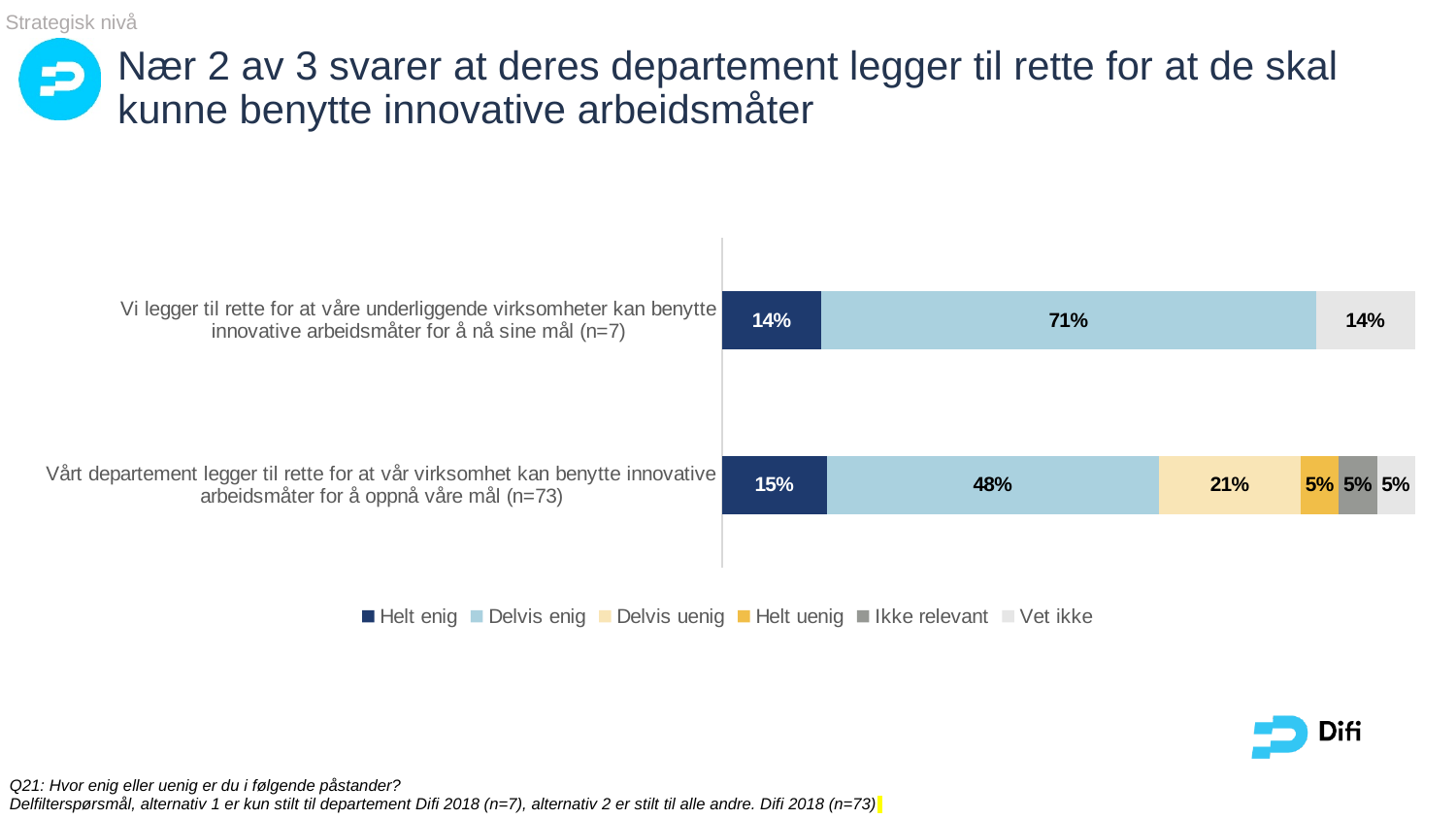
What is the 'Helt enig' value for the statement 'Vårt departement legger til rette for at vår virksomhet kan benytte innovative arbeidsmåter for å oppnå våre mål (n=73)'? 15% What is the difference between the 'Delvis enig' values of the two statements (71% vs 48%)? 23% What is the 'Delvis uenig' value for the statement 'Vårt departement legger til rette for at vår virksomhet kan benytte innovative arbeidsmåter for å oppnå våre mål (n=73)'? 21% Which statement has the larger 'Delvis enig' share: the one with n=7 or the one with n=73? The one with n=7 How many statements (categories) are plotted in the chart? 2 What is the 'Helt uenig' value for the statement 'Vårt departement legger til rette for at vår virksomhet kan benytte innovative arbeidsmåter for å oppnå våre mål (n=73)'? 5% What is the 'Delvis enig' value for the statement 'Vi legger til rette for at våre underliggende virksomheter kan benytte innovative arbeidsmåter for å nå sine mål (n=7)'? 71% What is the 'Helt enig' value for the statement 'Vi legger til rette for at våre underliggende virksomheter kan benytte innovative arbeidsmåter for å nå sine mål (n=7)'? 14% How many series does the legend list? 6 Which legend entry is shown in the darkest blue colour? Helt enig What is the 'Delvis enig' value for the statement 'Vårt departement legger til rette for at vår virksomhet kan benytte innovative arbeidsmåter for å oppnå våre mål (n=73)'? 48% What kind of chart is shown on the slide? Stacked bar chart